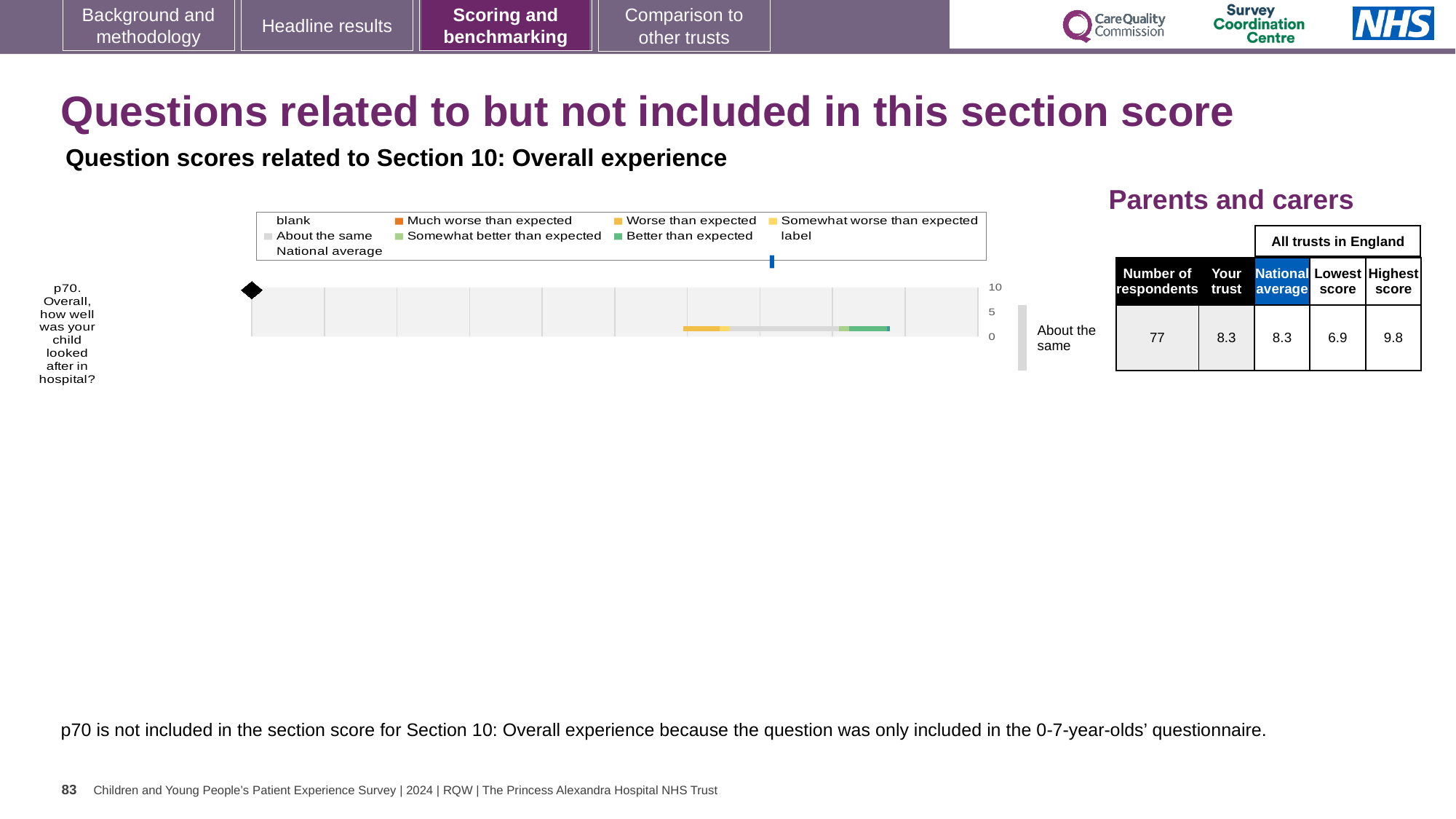
What is the national average score for p70? 8.3 How is the trust's p70 result categorised relative to other trusts? About the same What is the lowest score among all trusts in England for p70? 6.9 What kind of chart is used to show the p70 question score? bar chart What is the 'Your trust' score for p70? 8.3 What is the highest score among all trusts in England for p70? 9.8 What is the difference between the highest and lowest scores among all trusts in England for p70? 2.9 How many respondents answered p70? 77 Is the trust's score for p70 higher than, lower than, or the same as the national average? the same What is the highest value shown on the chart's axis? 10 How many questions are plotted in the chart? 1 Which question is plotted in the chart? p70. Overall, how well was your child looked after in hospital?